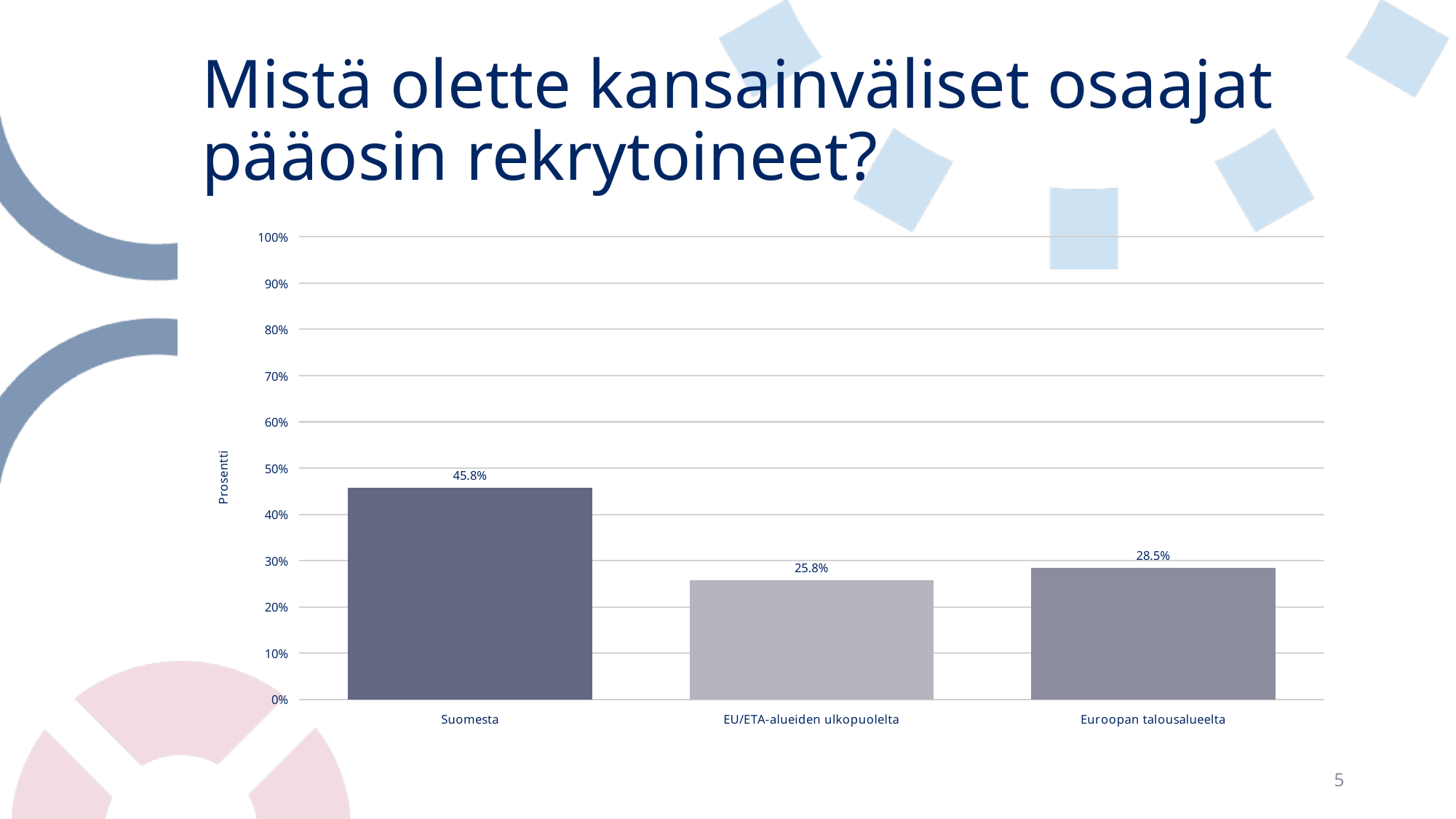
What is the difference between the values for Euroopan talousalueelta and EU/ETA-alueiden ulkopuolelta? 2.7% Which category has the highest value? Suomesta What is the value for Suomesta? 45.8% What kind of chart is shown on the slide? bar chart How many categories are shown in the chart? 3 What is the value for Euroopan talousalueelta? 28.5% What is the value for EU/ETA-alueiden ulkopuolelta? 25.8% What is the label of the vertical axis? Prosentti Which category has the lowest value? EU/ETA-alueiden ulkopuolelta What is the difference between the values for Suomesta and Euroopan talousalueelta? 17.3% Is the value for Suomesta greater or less than 50%? less Which is larger, the value for Suomesta or the value for EU/ETA-alueiden ulkopuolelta? Suomesta